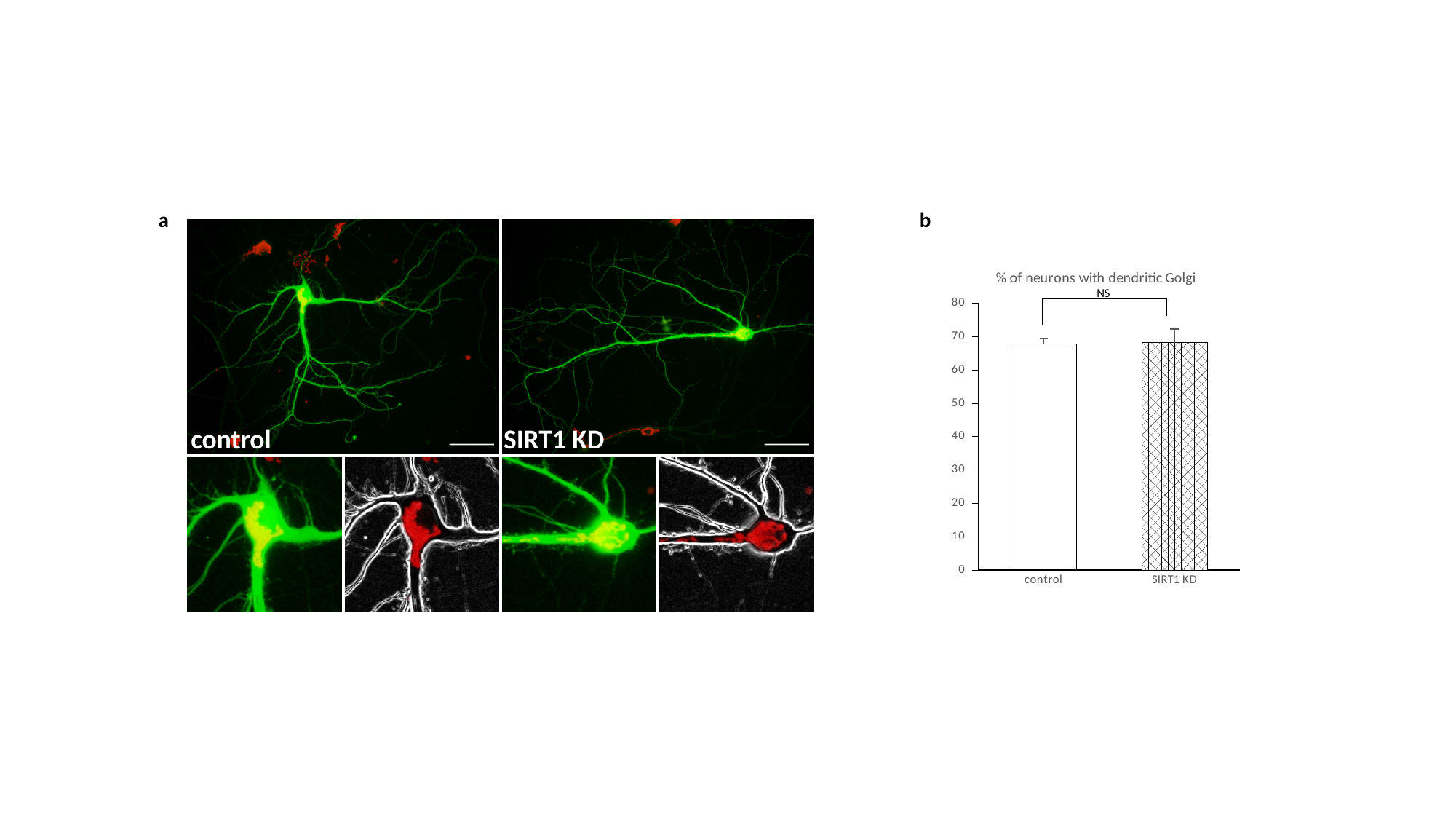
In the chart in panel b, is the value for control greater or less than 60? greater What kind of chart is shown in panel b? bar chart In the chart in panel b, is the value for SIRT1 KD greater or less than 50? greater What is the title of the chart in panel b? % of neurons with dendritic Golgi In the chart in panel b, is the value for SIRT1 KD greater or less than 70? less How many categories are plotted on the x axis of the chart in panel b? 2 What is the highest tick value shown on the y axis of the chart in panel b? 80 What are the two category labels on the x axis of the chart in panel b? control and SIRT1 KD